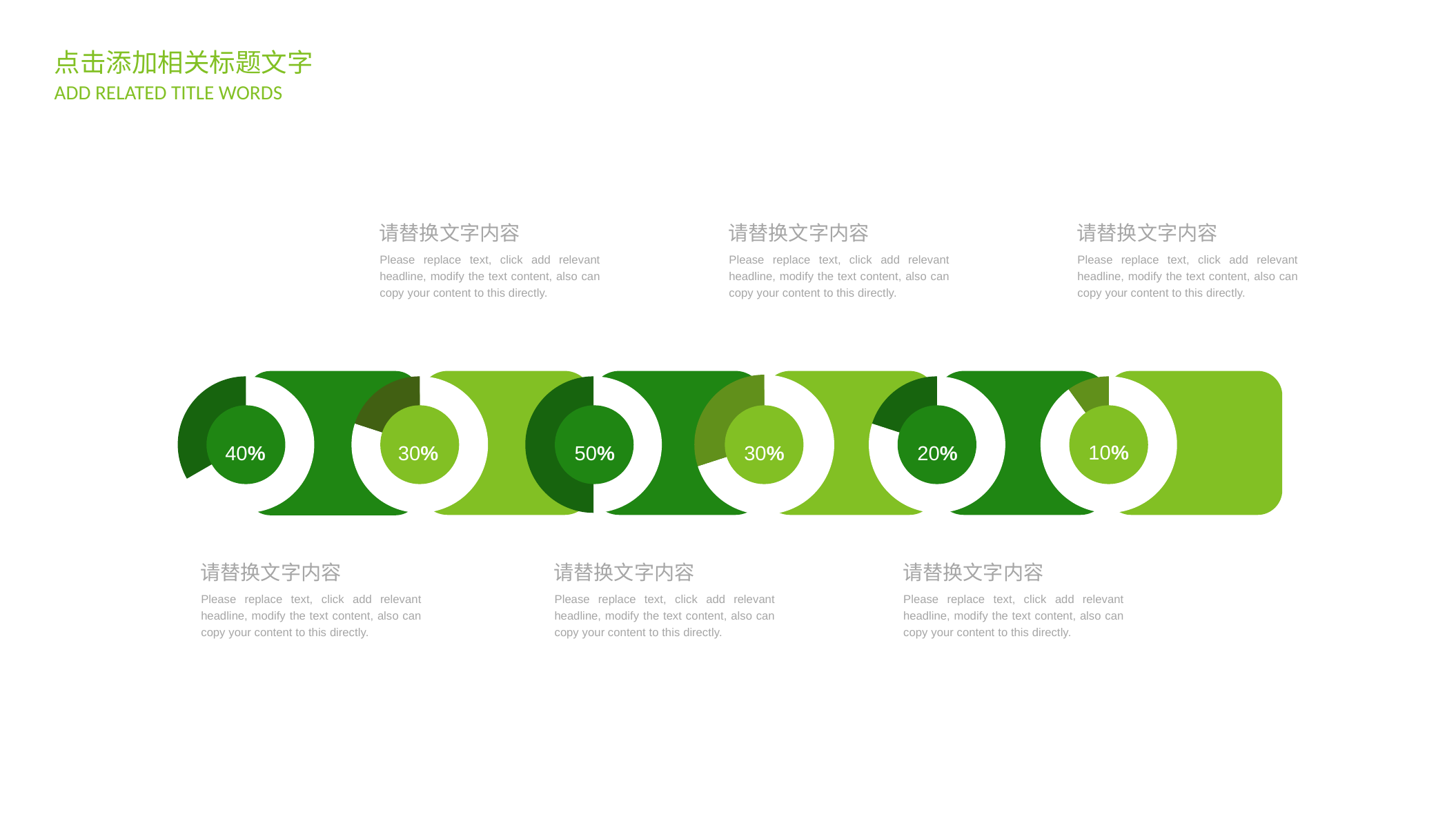
Which ring chart shows the highest percentage? The third from the left (50%) What is the difference between the first ring chart's value (40%) and the second ring chart's value (30%)? 10% Which ring chart shows the lowest percentage? The sixth (rightmost), 10% How many ring charts are shown on the slide? 6 What is the difference between the value in the third ring chart (50%) and the value in the sixth ring chart (10%)? 40% What value is shown in the third ring chart from the left? 50% What value is shown in the first (leftmost) ring chart? 40% Which is larger, the value in the first ring chart or the value in the fifth ring chart? The first ring chart (40%) What value is shown in the sixth (rightmost) ring chart? 10% What kind of chart is used to display the percentages on the slide? Ring (donut) chart What value is shown in the fifth ring chart from the left? 20% How many of the ring charts show a value of 30%? 2